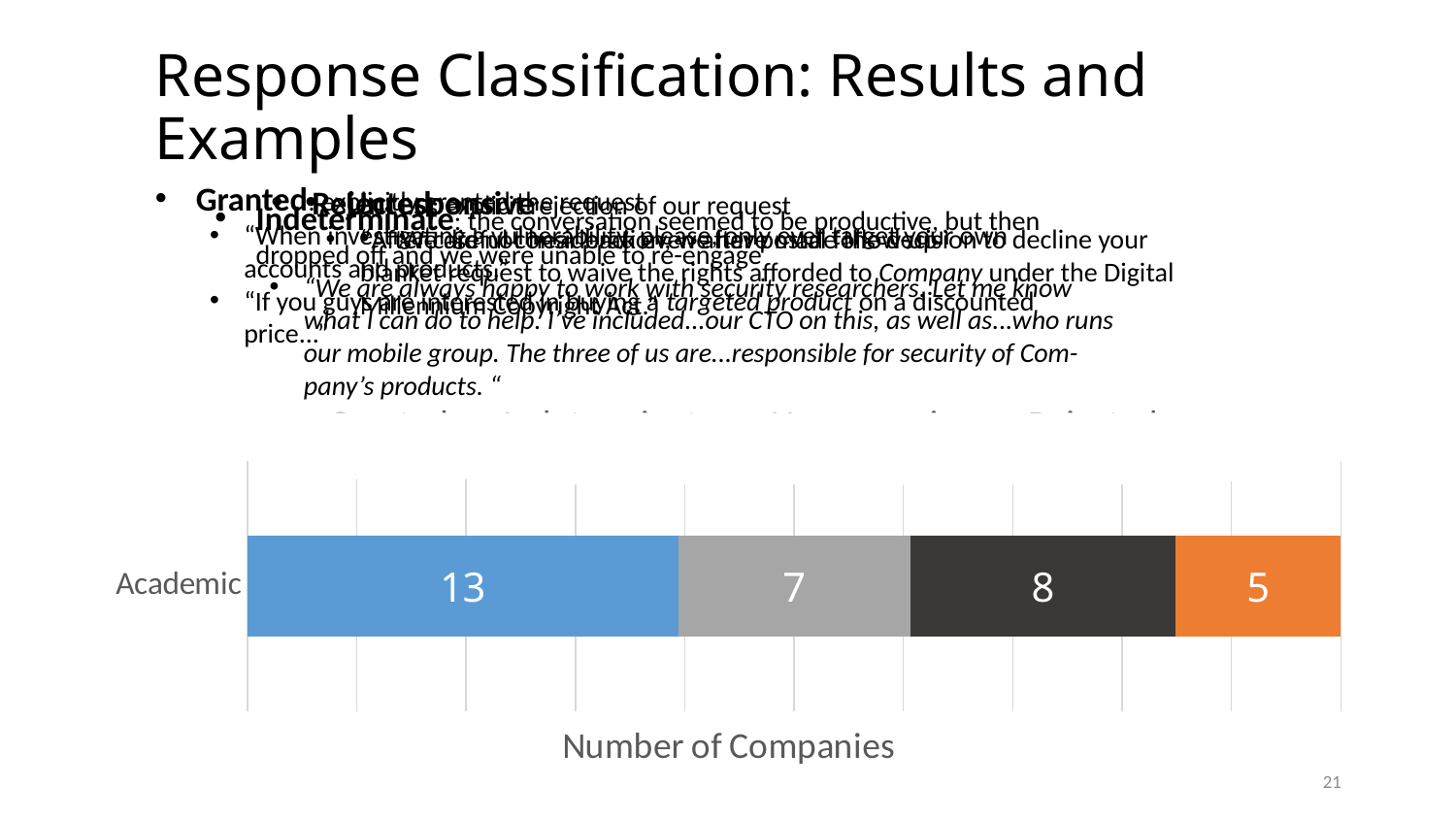
How many categories are shown on the vertical axis of the chart? 1 What is the value of the blue segment of the Academic bar? 13 What is the value of the light gray segment of the Academic bar? 7 Which segment of the Academic bar has the largest value? the blue segment (13) What kind of chart is shown on the slide? stacked bar chart What is the value of the orange segment of the Academic bar? 5 What is the title of the horizontal axis of the chart? Number of Companies What is the difference between the blue segment and the orange segment of the Academic bar? 8 What is the total of the Academic stacked bar? 33 Which segment of the Academic bar has the smallest value? the orange segment (5) Which is larger in the Academic bar, the light gray segment or the dark gray segment? the dark gray segment What is the value of the dark gray segment of the Academic bar? 8